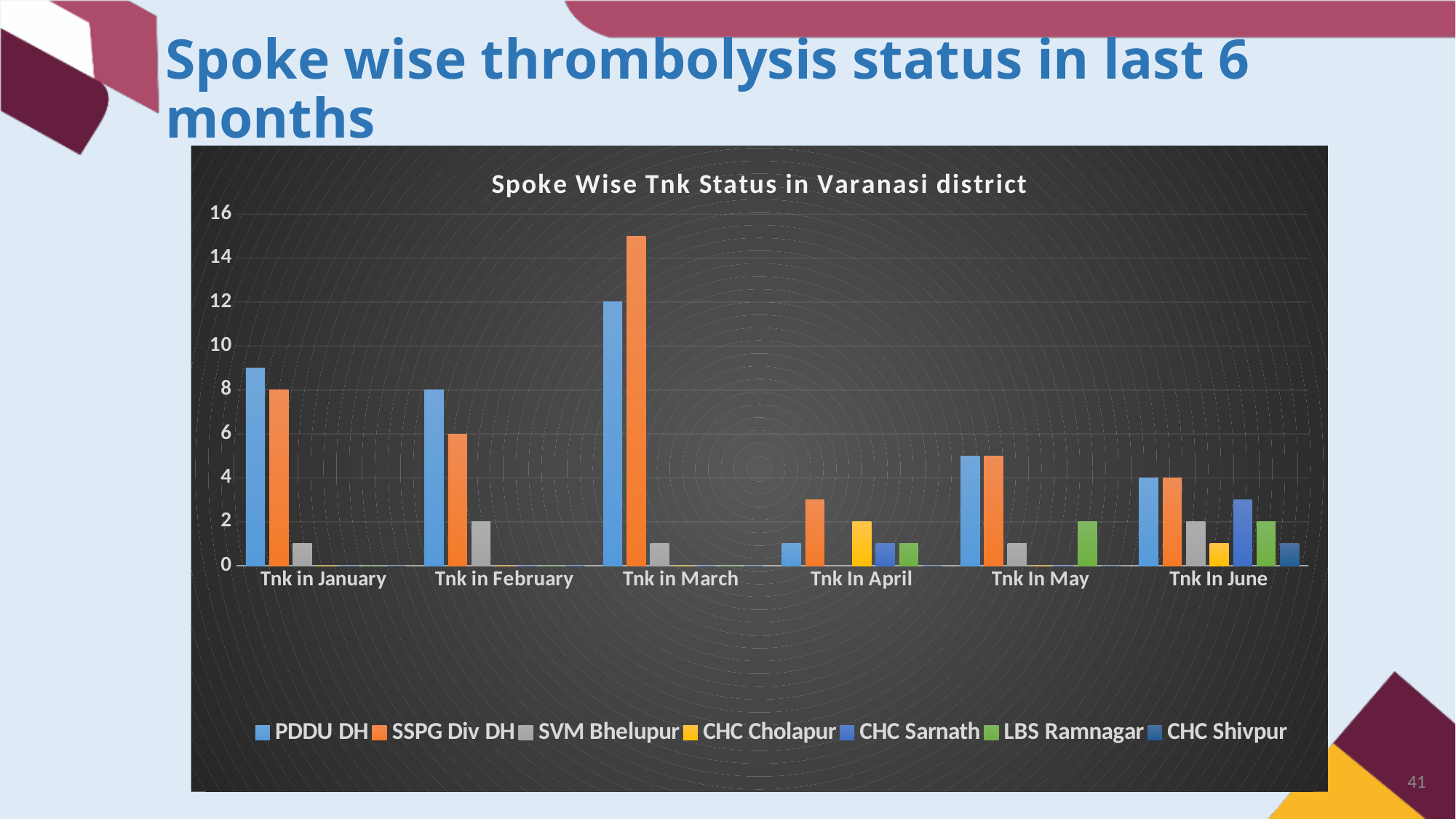
What is the value for PDDU DH in Tnk in March? 12 What is the value for SSPG Div DH in Tnk in January? 8 What is the difference between PDDU DH and SVM Bhelupur in Tnk in February? 6 What kind of chart is shown on the slide? bar chart How many month categories are shown on the x axis? 6 What is the value for CHC Cholapur in Tnk In April? 2 How many series does the legend list? 7 What is the value for SSPG Div DH in Tnk in February? 6 Is the value for SSPG Div DH in Tnk in March greater or less than 14? greater In which month is the SSPG Div DH bar the highest? Tnk in March What is the title of the chart? Spoke Wise Tnk Status in Varanasi district In Tnk in March, which is larger: PDDU DH or SSPG Div DH? SSPG Div DH